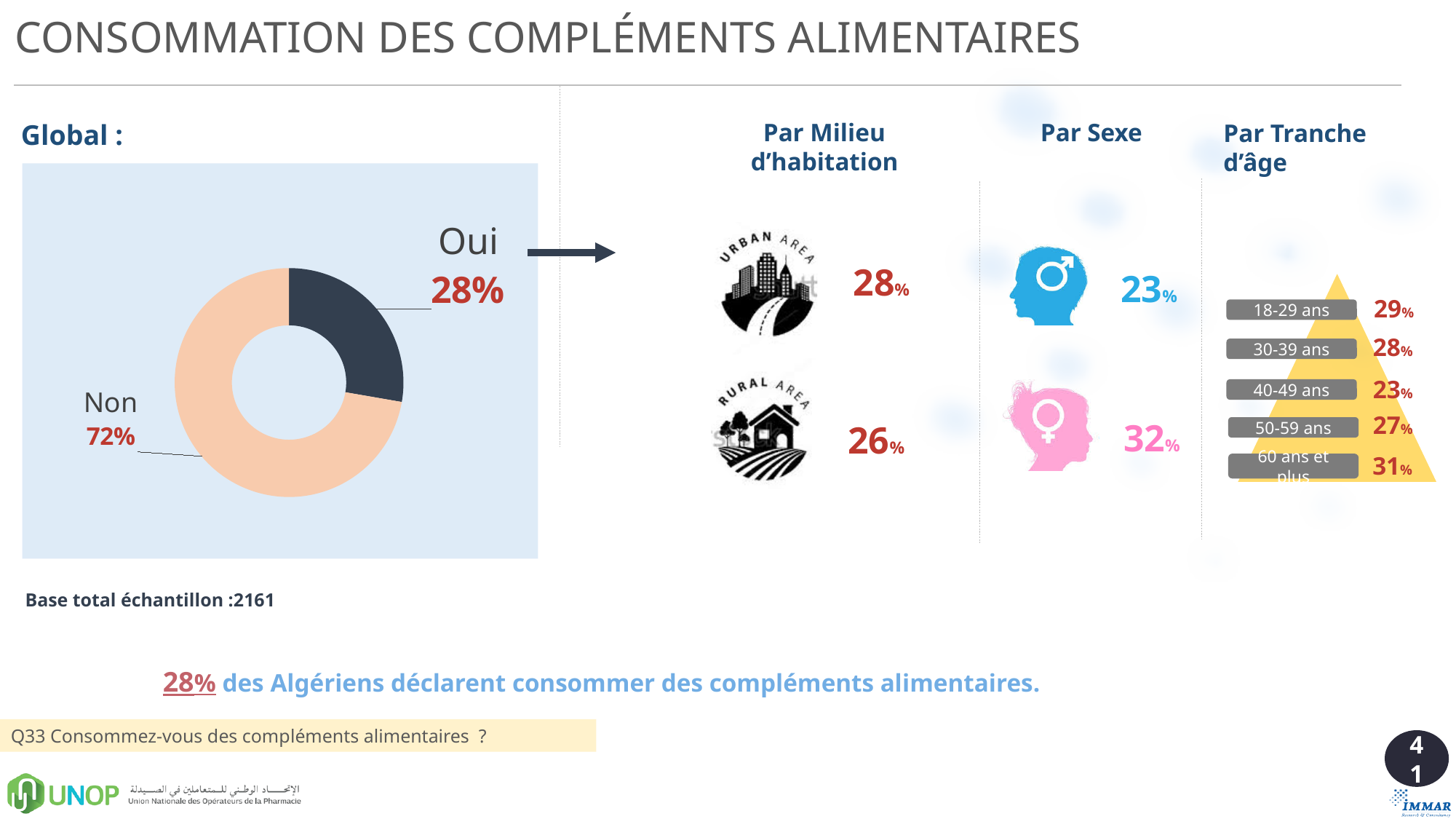
In the "Par Tranche d'âge" section, which age group has the lowest percentage? 40-49 ans How many categories does the Global donut chart show? 2 In the Global donut chart, which colour represents "Oui"? Dark navy In the "Par Sexe" section, which sex has the higher percentage? Female (32%) In the Global donut chart, which category is the largest? Non In the Global donut chart, what percentage is shown for "Non"? 72% In the Global donut chart, what percentage is shown for "Oui"? 28% In the Global donut chart, what is the difference between the "Non" and "Oui" shares? 44% In the "Par Tranche d'âge" section, what percentage is shown for "60 ans et plus"? 31% What is the base total sample size stated on the slide? 2161 In the "Par Milieu d'habitation" section, what percentage is shown for the rural area? 26% What kind of chart is used in the Global section? Donut (pie) chart